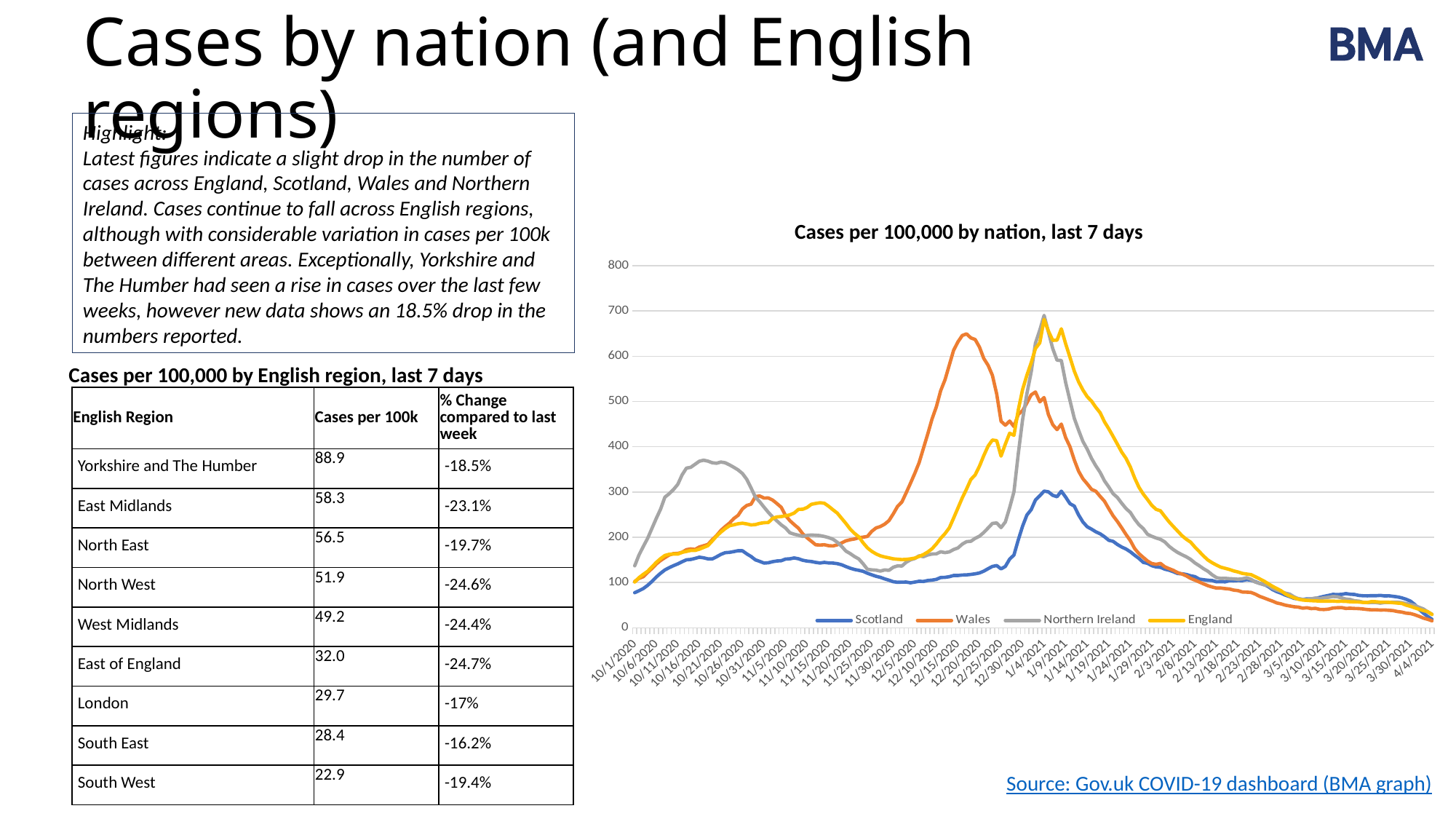
Which colour is used for the England line in the chart? yellow Do the values for all four nations rise or fall between 1/9/2021 and 4/4/2021? fall What kind of chart is shown on the slide? line chart Which nation's line is highest around 10/21/2020? Northern Ireland Around 12/15/2020, which is larger: the value for Wales or the value for Scotland? Wales Is the peak value for Scotland greater or less than 400? less Is the value for Scotland at 10/1/2020 greater or less than 100? less Which nation's line has the lowest peak in the chart? Scotland What is the title of the chart on the slide? Cases per 100,000 by nation, last 7 days Which nation's line is highest around 12/15/2020? Wales Is the peak value for Wales greater or less than 600? greater How many series does the legend of the chart list? 4